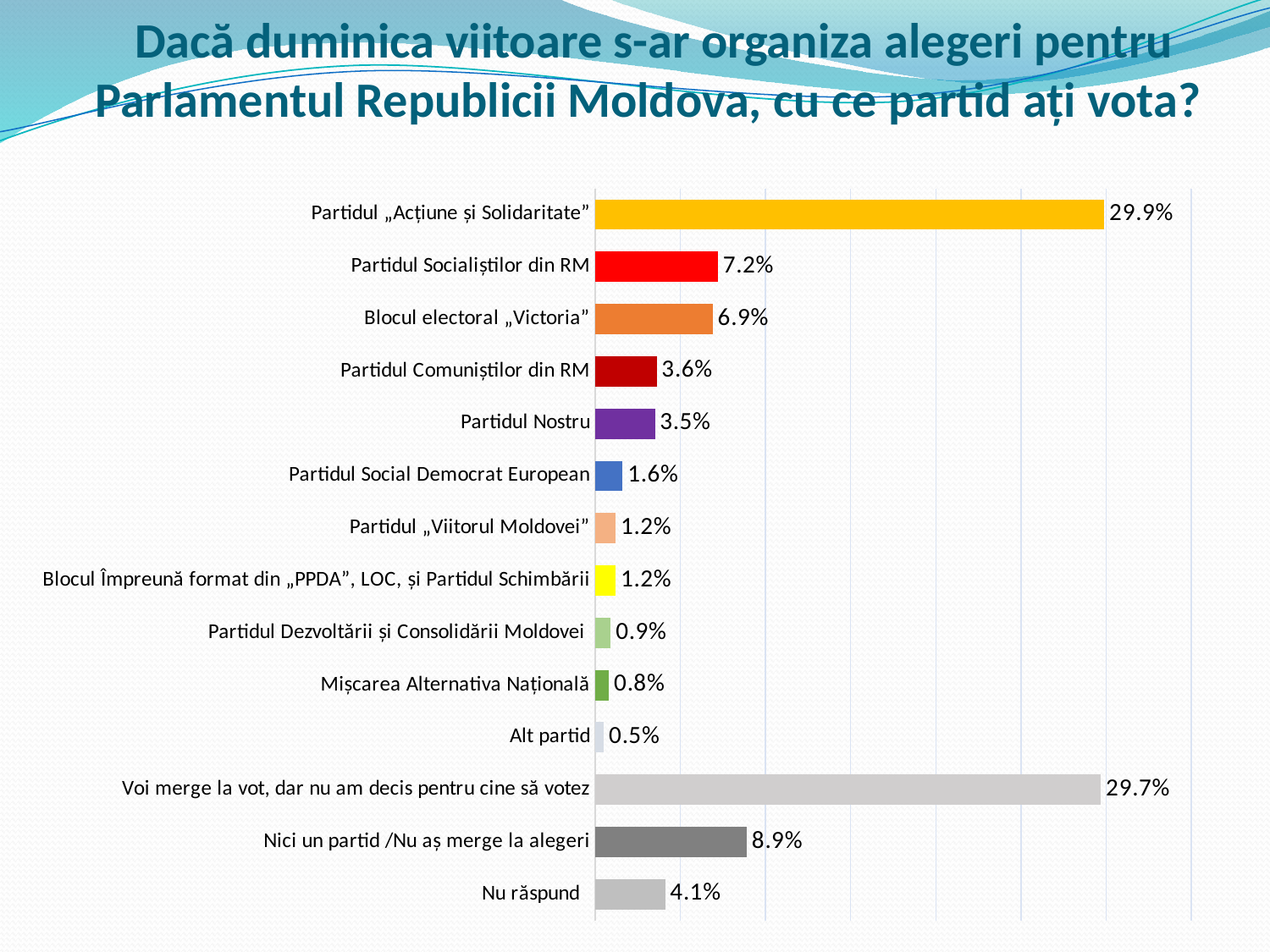
What colour is the bar for Partidul „Acțiune și Solidaritate”? Yellow What percentage is shown for "Voi merge la vot, dar nu am decis pentru cine să votez"? 29.7% What value is shown for Partidul Socialiștilor din RM? 7.2% What percentage of respondents would vote for Partidul „Acțiune și Solidaritate”? 29.9% Which has a larger value: Partidul Socialiștilor din RM or Blocul electoral „Victoria”? Partidul Socialiștilor din RM What percentage is shown for Partidul Nostru? 3.5% What kind of chart is shown on the slide? Bar chart Which category has the lowest value in the chart? Alt partid How many categories are shown in the chart? 14 What is the difference between the values for Partidul „Acțiune și Solidaritate” and Partidul Socialiștilor din RM? 22.7 percentage points What value is shown for Nu răspund? 4.1% Which category has the highest value in the chart? Partidul „Acțiune și Solidaritate”